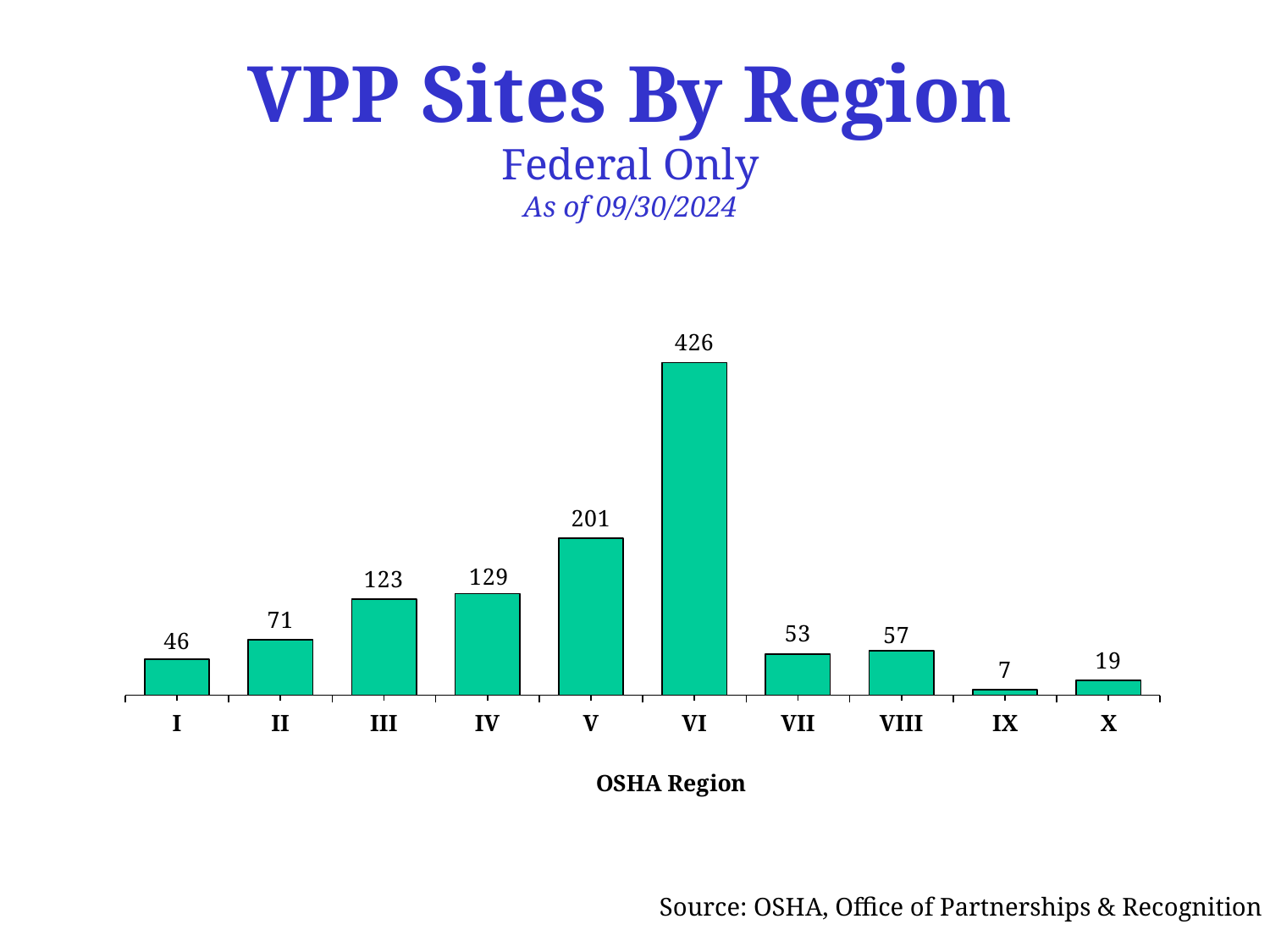
Which has more VPP sites, Region II or Region X? Region II What kind of chart is shown on the slide? Bar chart What is the date given on the slide for the data? As of 09/30/2024 Which has more VPP sites, Region VIII or Region VII? Region VIII What is the value shown for Region III? 123 What is the difference between the values for Region IV and Region III? 6 How many VPP sites are in OSHA Region VI? 426 Which OSHA region has the lowest number of VPP sites? IX Which OSHA region has the highest number of VPP sites? VI What is the x-axis title of the chart? OSHA Region How many OSHA regions are shown on the x axis? 10 What is the difference between the values for Region VI and Region V? 225